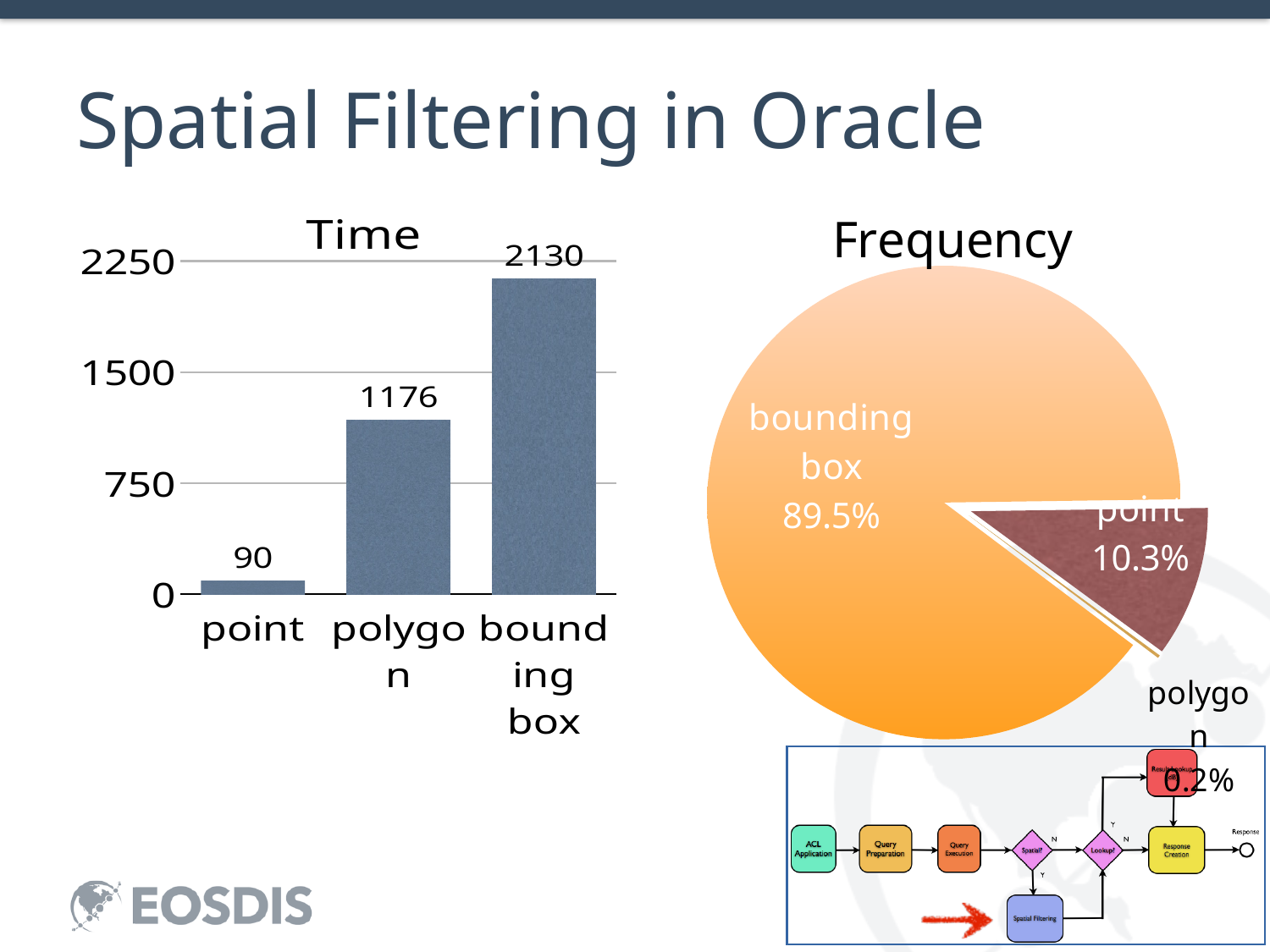
In the Time chart, what is the value for polygon? 1176 What kind of chart is the Time chart? bar chart In the Frequency chart, what share does bounding box have? 89.5% In the Time chart, what is the value for bounding box? 2130 What kind of chart is the Frequency chart? pie chart In the Time chart, which is larger, the value for polygon or the value for point? polygon In the Time chart, what is the difference between the values for bounding box and polygon? 954 In the Time chart, which category has the lowest value? point In the Frequency chart, what share does point have? 10.3% In the Time chart, how many categories are shown? 3 In the Time chart, which category has the highest value? bounding box In the Time chart, what is the value for point? 90